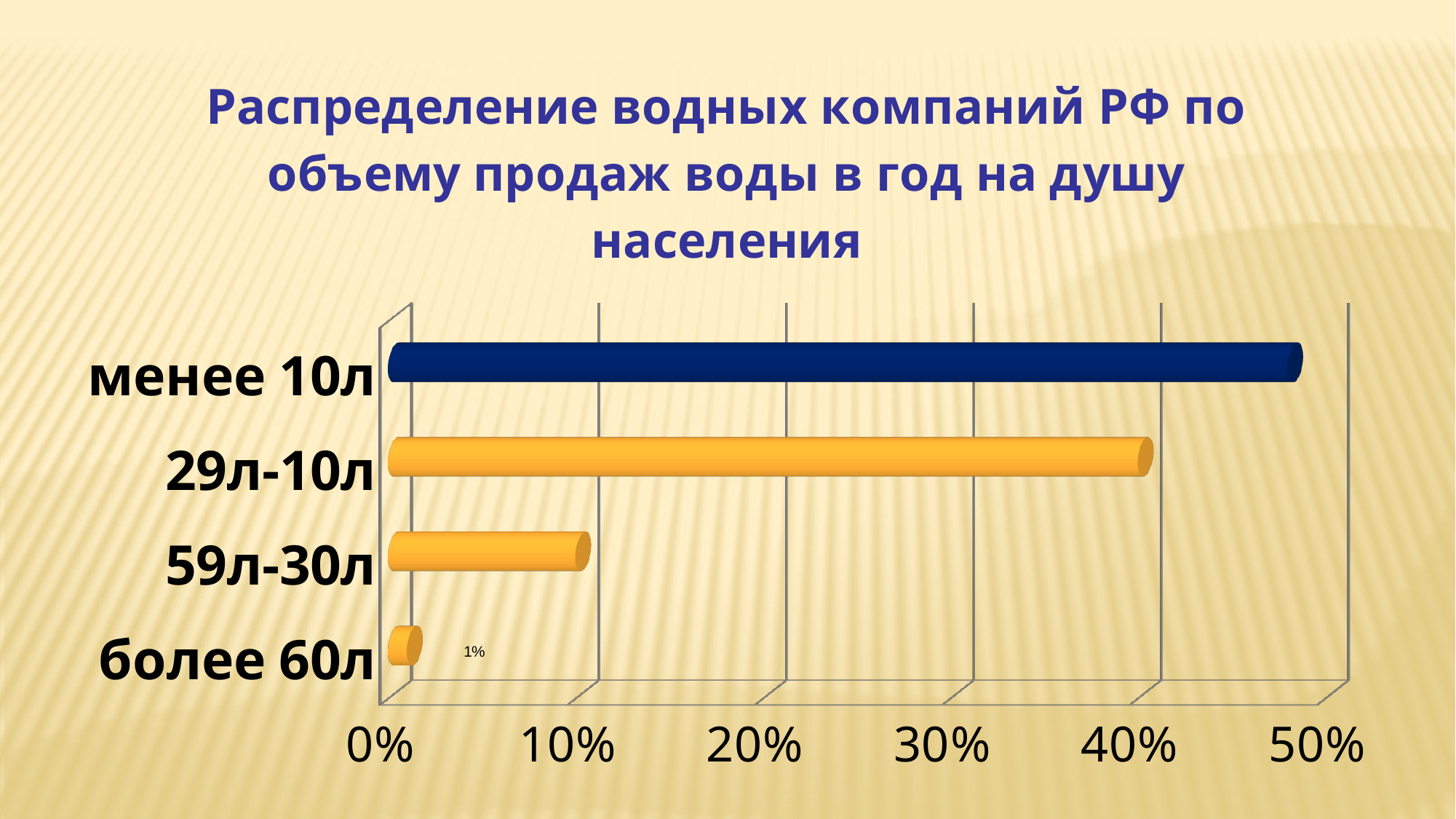
Which is larger, the value for "менее 10л" or the value for "29л-10л"? менее 10л Is the value for "59л-30л" greater or less than 20%? less What is the highest value shown on the horizontal axis? 50% Which is larger, the value for "59л-30л" or the value for "29л-10л"? 29л-10л What kind of chart is shown on the slide? bar chart Which category has the lowest value? более 60л Is the value for "29л-10л" greater or less than 30%? greater Do the values increase or decrease going from the top category to the bottom category? decrease Which category has the highest value? менее 10л Is the value for "менее 10л" greater or less than 40%? greater How many categories are plotted in the chart? 4 What is the value for the category "более 60л"? 1%